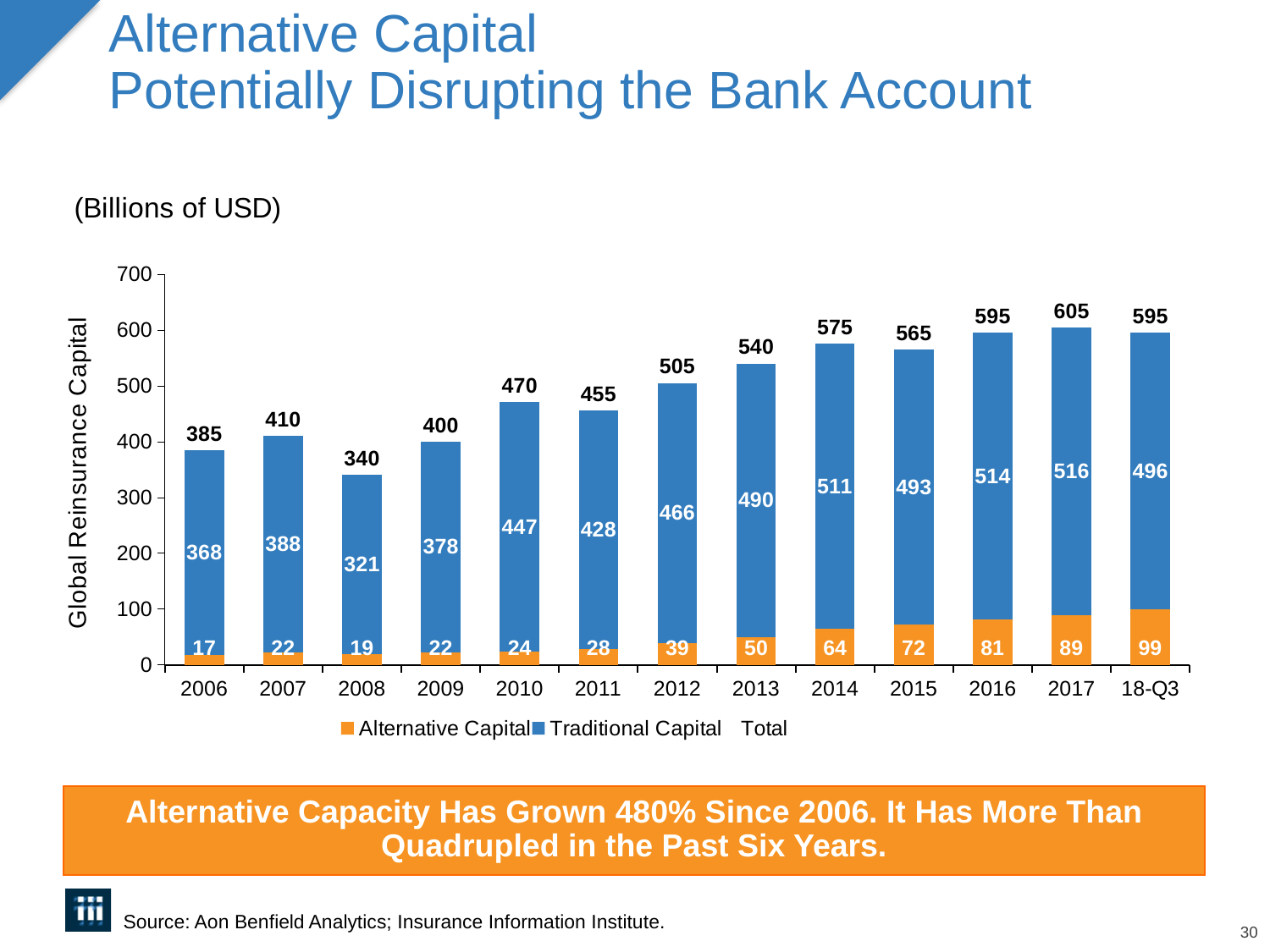
How many series does the legend list? 3 What is the Alternative Capital value for 2013? 50 Does the Alternative Capital value rise or fall from 2006 to 18-Q3? Rise Which is larger, the Traditional Capital value for 2016 or for 2015? 2016 Which year has the highest Total value? 2017 What is the label of the y axis? Global Reinsurance Capital What kind of chart is shown on the slide? Stacked bar chart What is the Traditional Capital value for 2017? 516 How many categories are shown on the x axis? 13 What is the Total value for 2008? 340 What is the difference between the Alternative Capital values for 18-Q3 and 2006? 82 Which year has the lowest Alternative Capital value? 2006